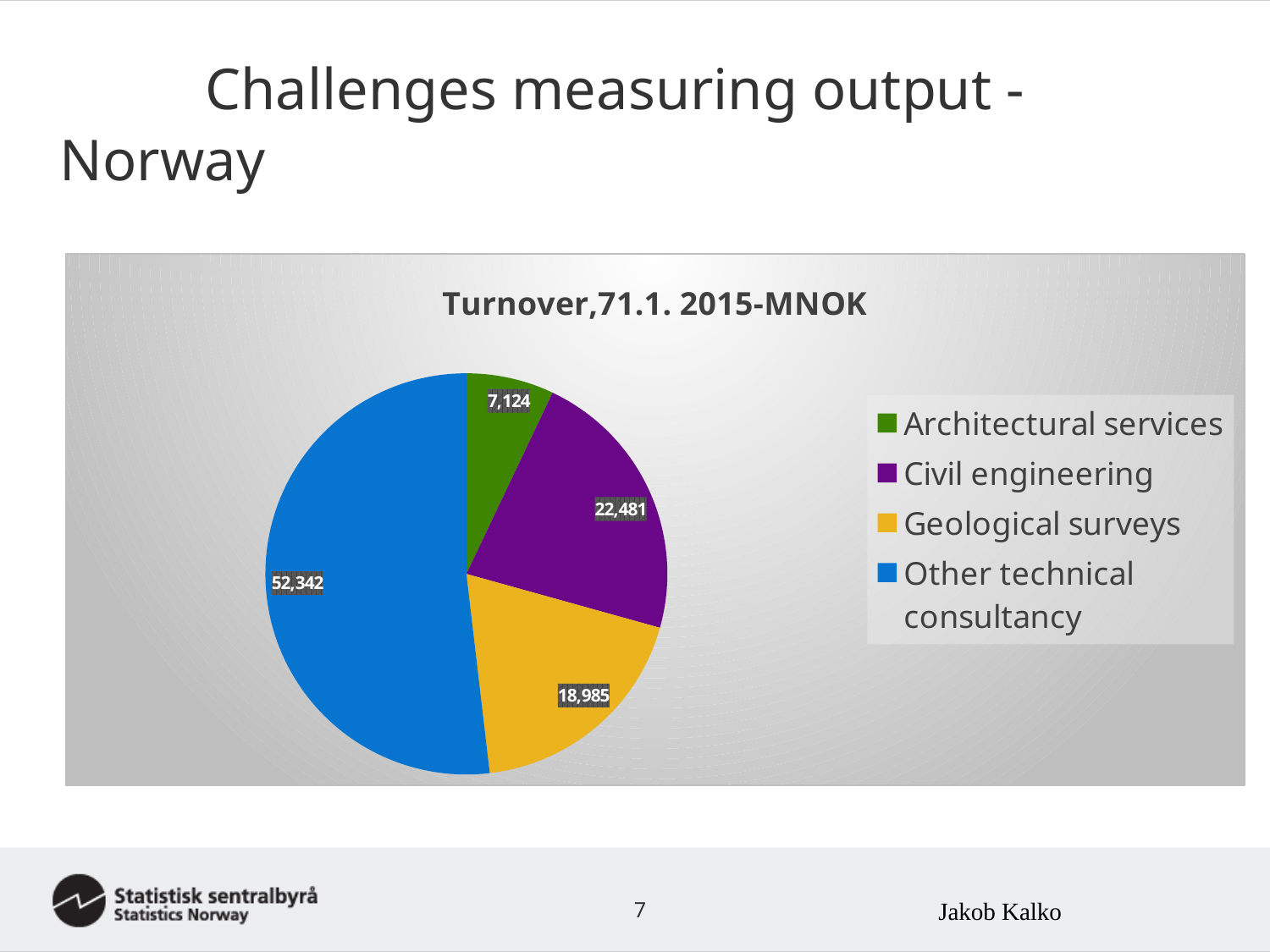
Which category has the smallest turnover? Architectural services What is the turnover value for Civil engineering? 22,481 What is the title of the chart? Turnover,71.1. 2015-MNOK Which is larger, the turnover for Civil engineering or Geological surveys? Civil engineering What kind of chart is shown on the slide? Pie chart What is the turnover value for Geological surveys? 18,985 What is the difference between the turnover for Other technical consultancy and Civil engineering? 29,861 Which category has the largest turnover? Other technical consultancy What is the turnover value for Other technical consultancy? 52,342 What is the turnover value for Architectural services? 7,124 What is the total turnover across all four categories? 100,932 How many categories does the pie chart show? 4